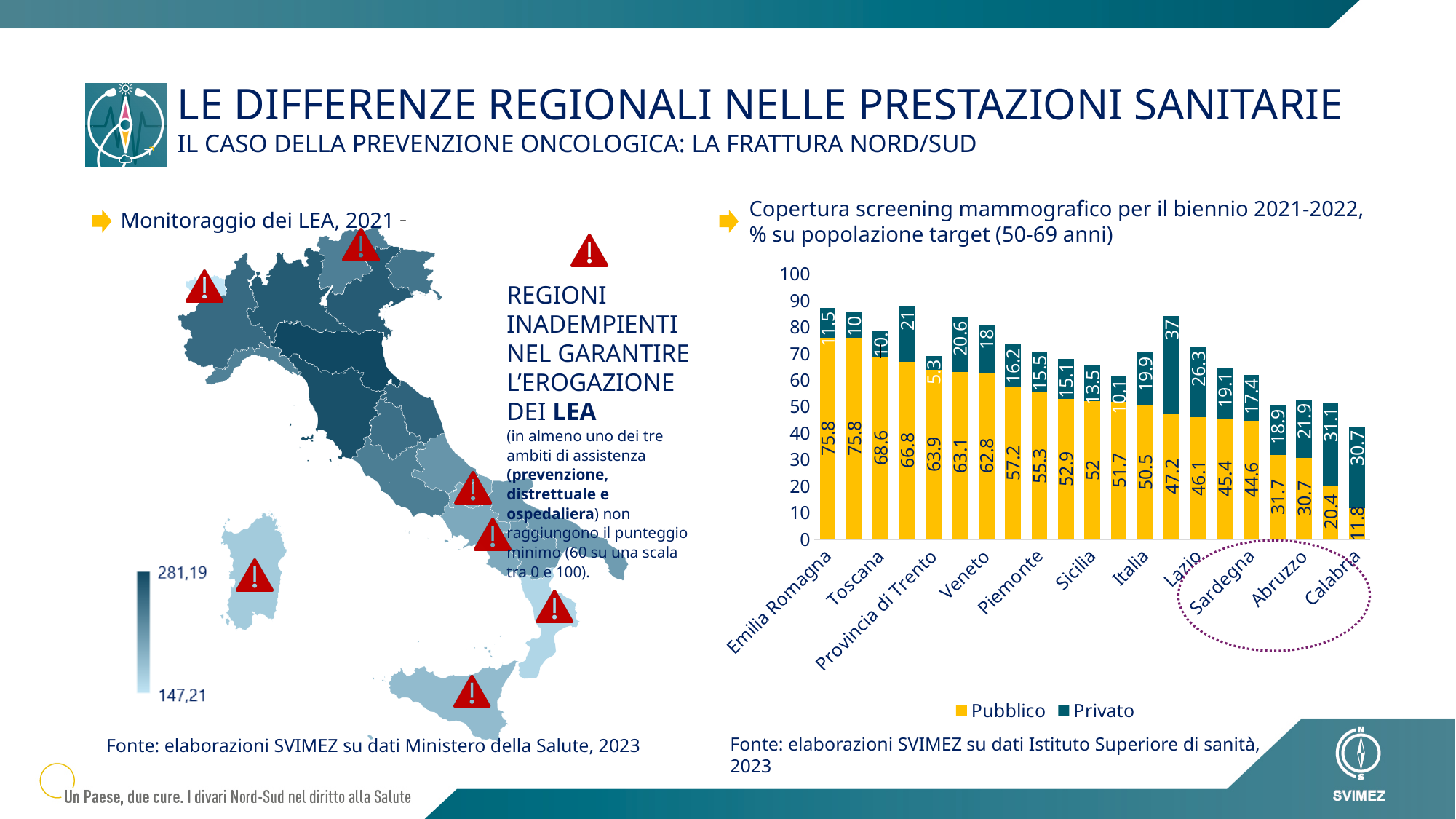
In the screening coverage chart, do the Pubblico values rise or fall from left to right along the x axis? Fall In the screening coverage chart, what is the difference between the Pubblico values of Emilia Romagna and Calabria? 64 In the screening coverage chart, what is the Privato value for Calabria? 30.7 How many series does the legend of the screening coverage chart list? 2 In the screening coverage chart, which labelled region has the lowest Pubblico value? Calabria In the screening coverage chart, what is the Pubblico value for Emilia Romagna? 75.8 In the screening coverage chart, what is the total of the stacked bar for Emilia Romagna? 87.3 In the screening coverage chart, which colour represents the Pubblico series? Yellow What kind of chart is shown on the right side of the slide? Stacked bar chart In the screening coverage chart, what is the Pubblico value for Italia? 50.5 In the screening coverage chart, which has the larger Pubblico value, Veneto or Piemonte? Veneto In the screening coverage chart, what is the total of the stacked bar for Calabria? 42.5